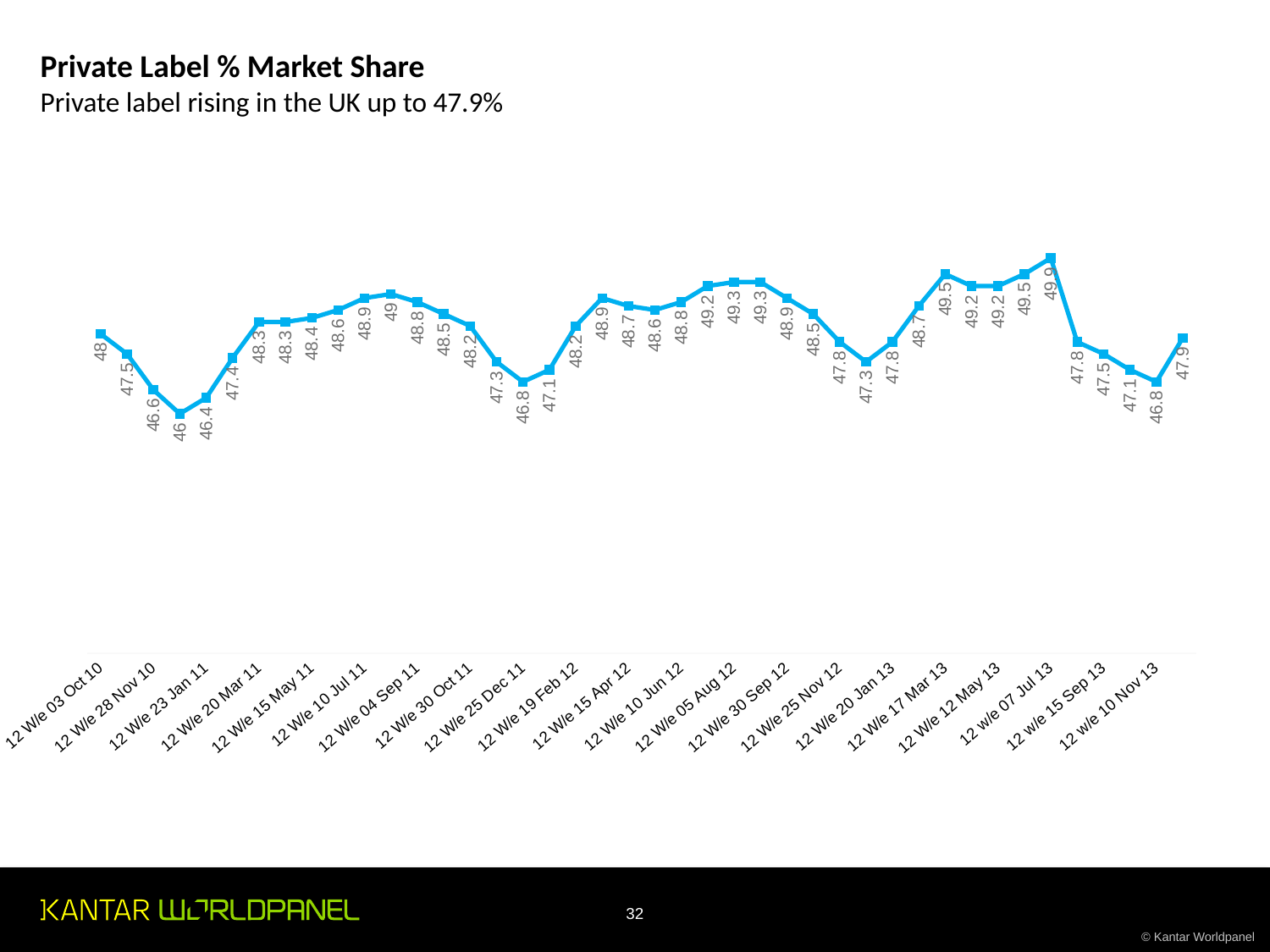
What is the title of the chart? Private Label % Market Share Does the line rise or fall between the peak of 49.9 and the next point? fall What is the value of the last point on the line? 47.9 What is the difference between the highest and lowest values on the line? 3.9 What is the lowest value plotted on the line? 46 Is the first point on the line (48) larger or smaller than the last point (47.9)? larger What is the difference between the first point (48) and the last point (47.9)? 0.1 What is the highest value plotted on the line? 49.9 What kind of chart is shown on the slide? line chart What is the value of the first point on the line (12 W/e 03 Oct 10)? 48 How many data points are plotted on the line? 42 According to the subtitle, what level has private label risen to in the UK? 47.9%